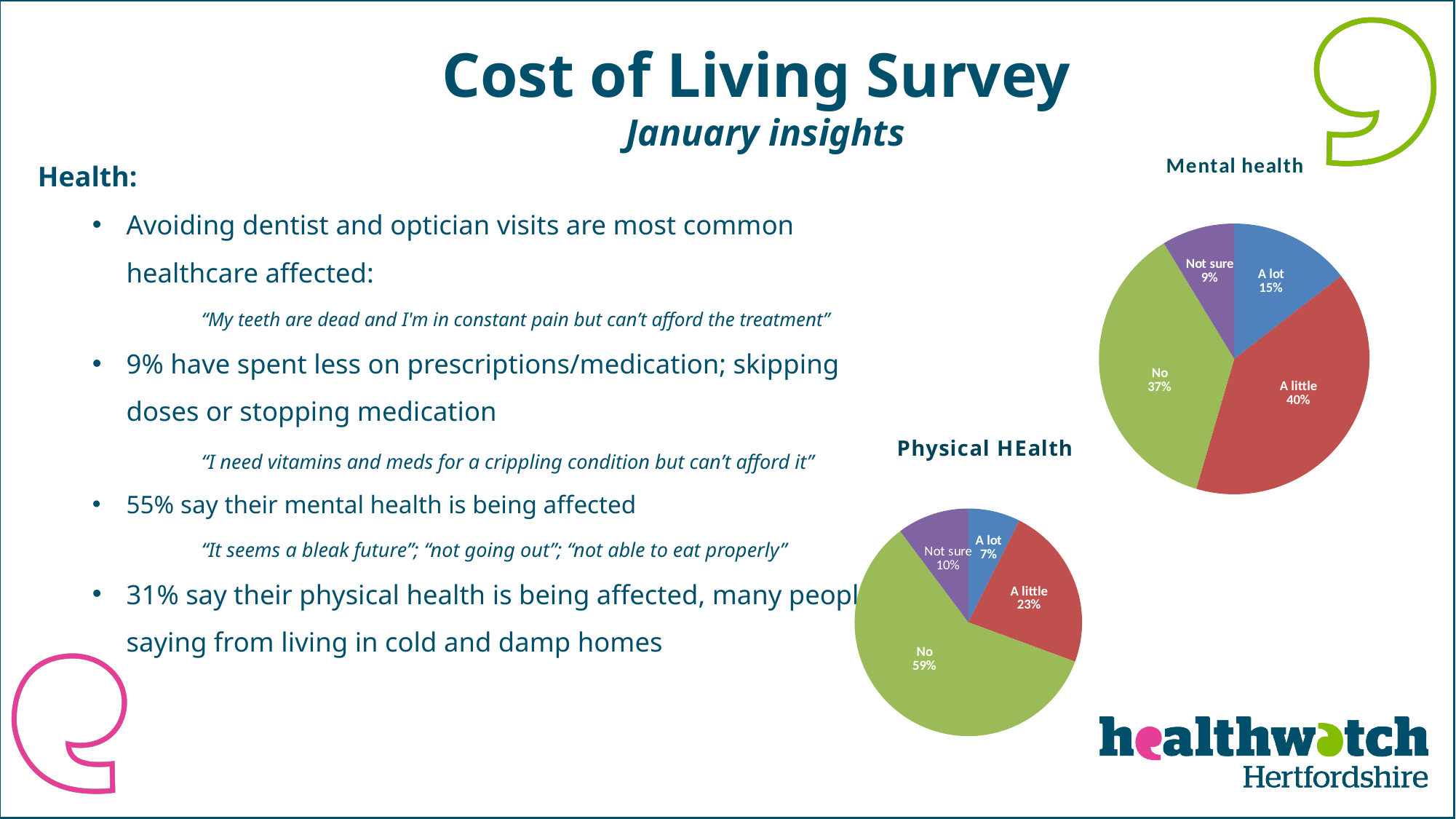
In the Mental health chart, what percentage is shown for 'A little'? 40% In the Physical HEalth chart, what percentage is shown for 'No'? 59% In the Mental health chart, what is the difference between the 'No' and 'A lot' percentages? 22% In the Mental health chart, what percentage is shown for 'Not sure'? 9% In the Physical HEalth chart, which is larger, 'A little' or 'Not sure'? A little In the Physical HEalth chart, what percentage is shown for 'A lot'? 7% In the Physical HEalth chart, what is the combined share of 'A lot' and 'A little'? 30% In the Mental health chart, what colour is the 'No' slice? Green In the Physical HEalth chart, which category has the smallest share? A lot In the Mental health chart, which category has the largest share? A little How many categories does the Mental health chart show? 4 What type of chart is the Physical HEalth chart? Pie chart